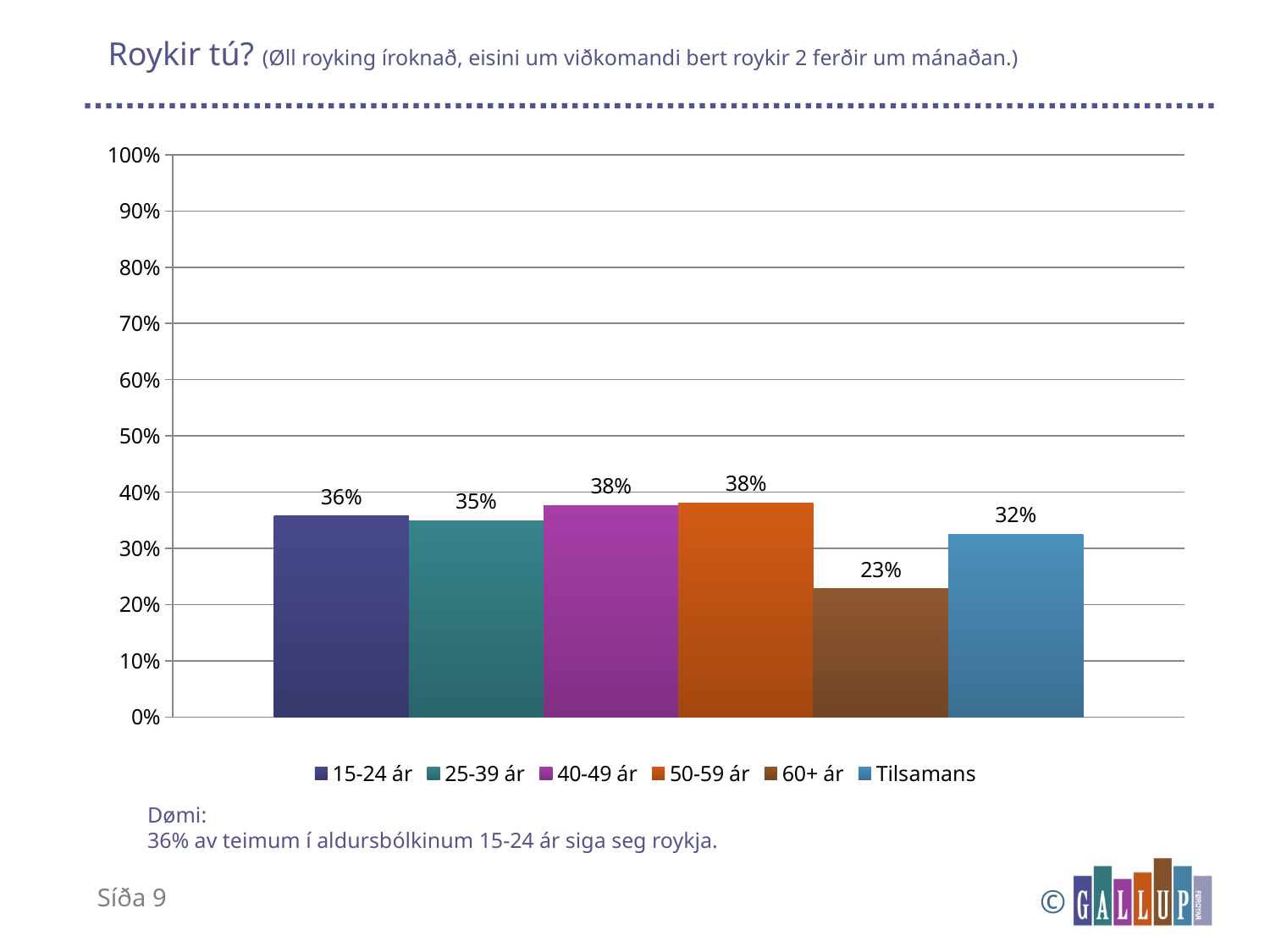
What is the title of the chart? Roykir tú? How many series does the legend list? 6 Is the value for 60+ ár greater or less than 30%? less What percentage is shown for the 25-39 ár group? 35% What is the value for Tilsamans? 32% What is the difference between the values for 50-59 ár and 60+ ár? 15% What percentage is shown for the 60+ ár group? 23% Which group has the lowest percentage? 60+ ár Which is larger, the value for 40-49 ár or the value for 25-39 ár? 40-49 ár What kind of chart is shown on the slide? bar chart What percentage is shown for the 15-24 ár group? 36% What is the difference between the values for 15-24 ár and Tilsamans? 4%